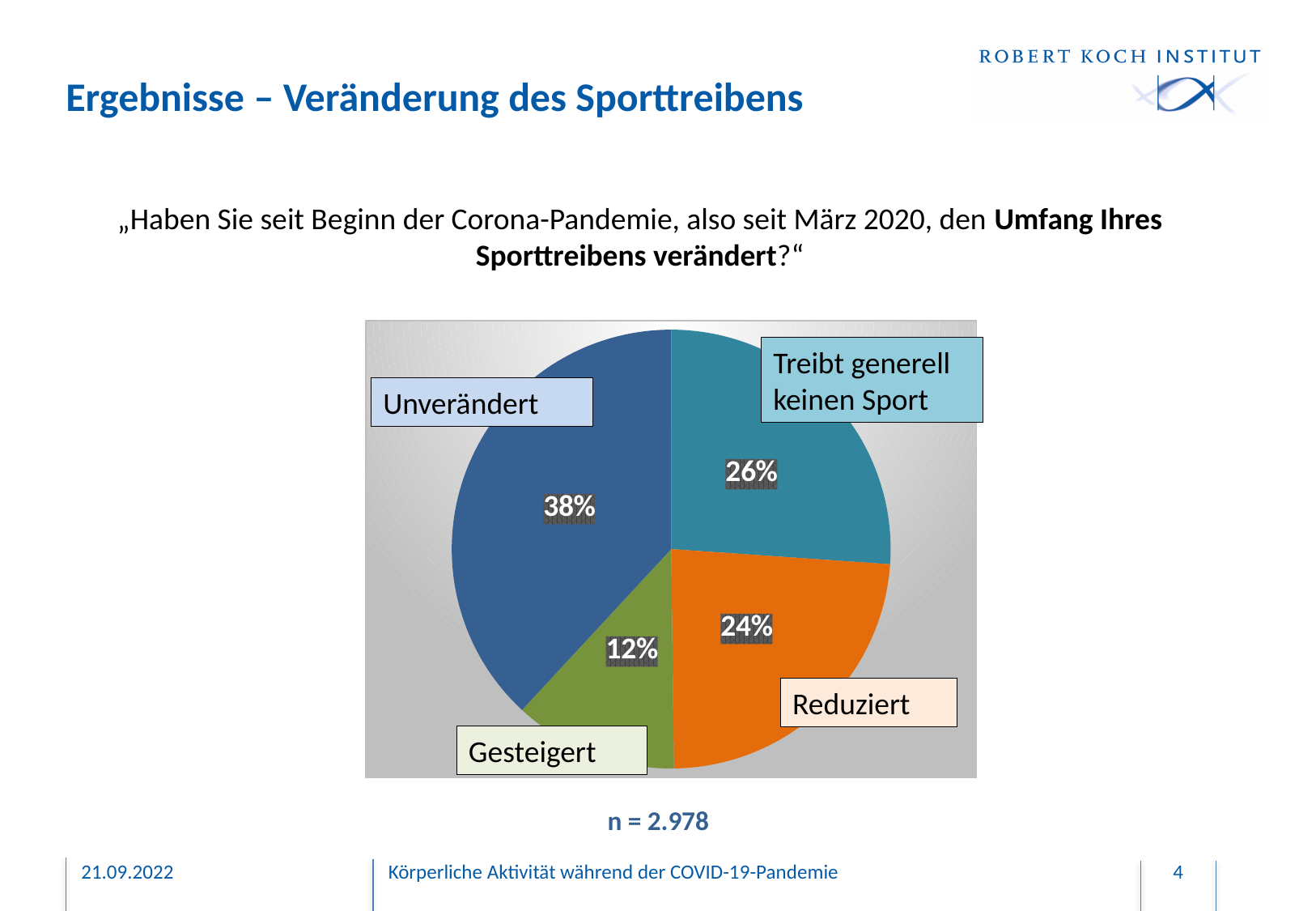
What colour is the "Reduziert" slice? orange What share of respondents answered "Treibt generell keinen Sport"? 26% What share of respondents answered "Gesteigert"? 12% What is the difference in percentage points between "Unverändert" and "Gesteigert"? 26 What share of respondents answered "Unverändert"? 38% What is the sample size (n) given below the chart? n = 2.978 What share of respondents answered "Reduziert"? 24% What kind of chart is shown on the slide? pie chart Which category has the smallest slice of the pie? Gesteigert Which is larger, the share for "Reduziert" or the share for "Gesteigert"? Reduziert Which category has the largest slice of the pie? Unverändert How many slices does the pie chart have? 4